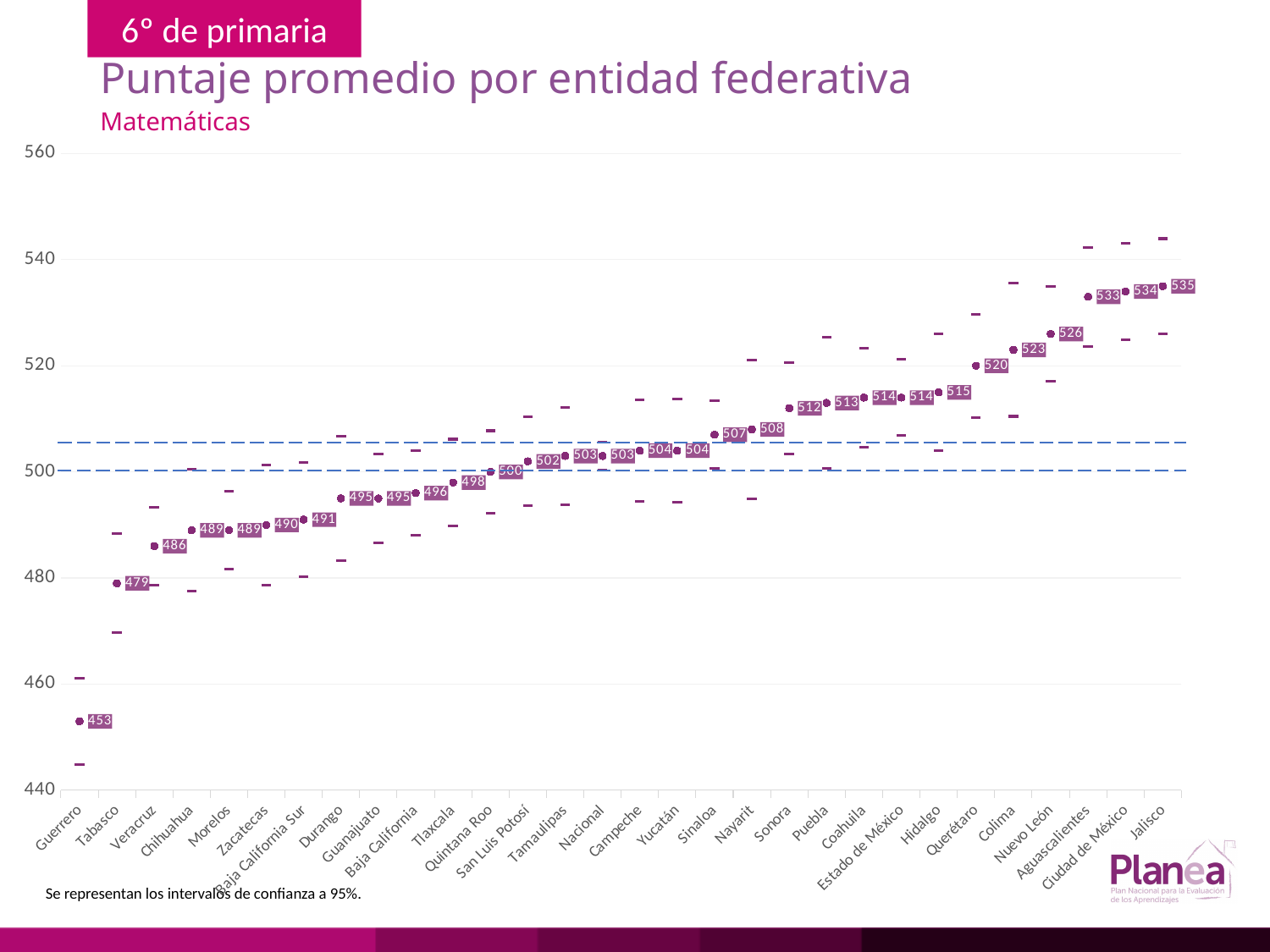
What is the difference between the scores of Jalisco and Guerrero? 82 What is the average score shown for Jalisco? 535 What is the average score for Querétaro? 520 What is the value plotted for Nacional? 503 What is the average mathematics score for Guerrero? 453 Which entity has the highest average score? Jalisco What subject is shown in the chart's subtitle? Matemáticas How many entities (categories) are plotted on the x axis? 30 Which has a higher average score, Nuevo León or Colima? Nuevo León Which entity has the lowest average score? Guerrero Is the value for Tabasco greater or less than 480? less Do the plotted values rise or fall from left to right along the x axis? rise